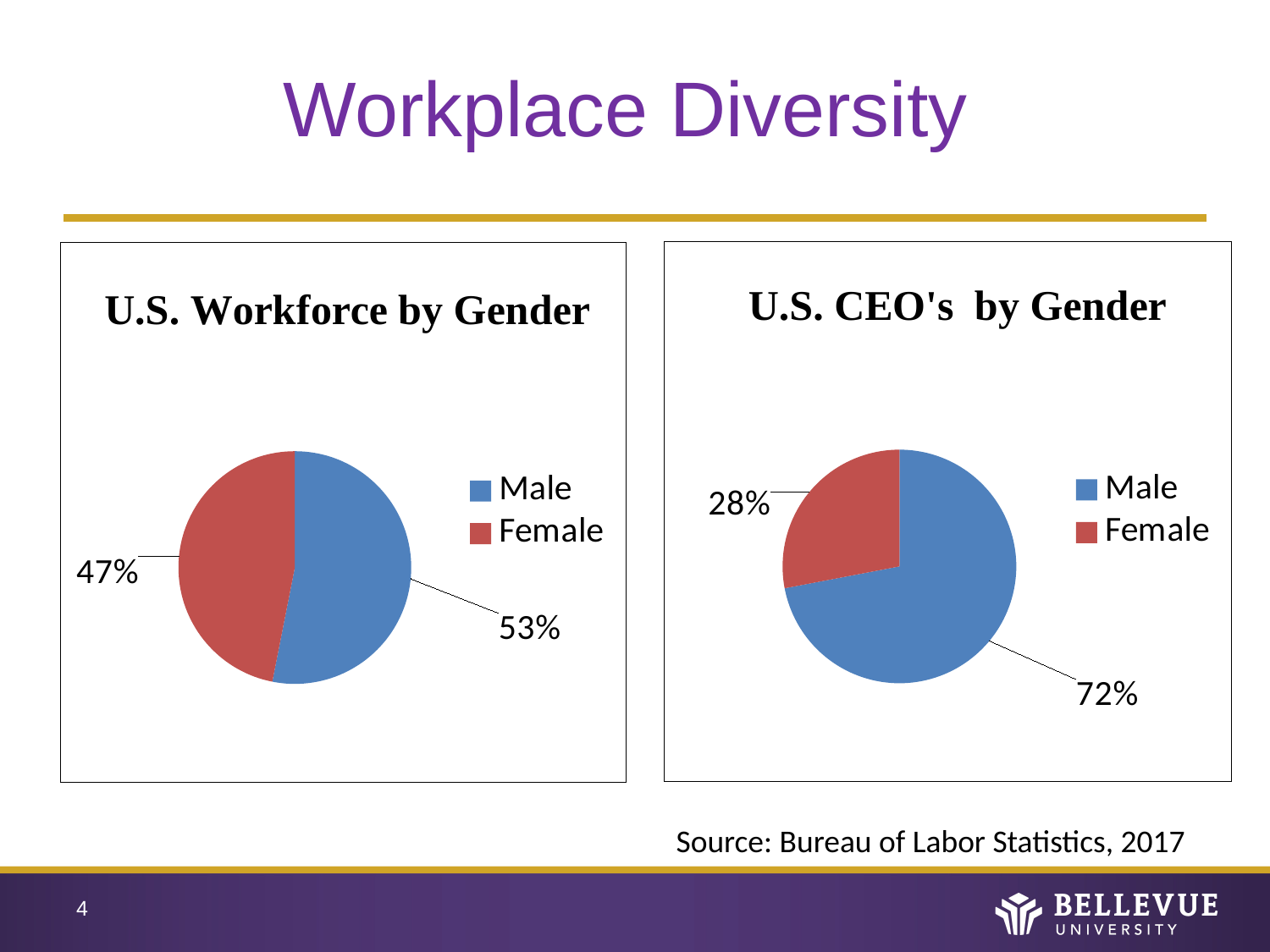
In the 'U.S. Workforce by Gender' chart, what colour represents Female? Red Is the Male share larger in the 'U.S. Workforce by Gender' chart or the 'U.S. CEO's by Gender' chart? U.S. CEO's by Gender In the 'U.S. CEO's by Gender' chart, which category has the largest slice? Male In the 'U.S. Workforce by Gender' chart, what is the difference between the Male and Female percentages? 6% In the 'U.S. CEO's by Gender' chart, what is the difference between the Male and Female percentages? 44% In the 'U.S. CEO's by Gender' chart, what percentage is Male? 72% In the 'U.S. Workforce by Gender' chart, which category has the smallest slice? Female In the 'U.S. CEO's by Gender' chart, what percentage is Female? 28% What type of chart is the 'U.S. Workforce by Gender' chart? Pie chart In the 'U.S. Workforce by Gender' chart, what percentage is Male? 53% In the 'U.S. Workforce by Gender' chart, what percentage is Female? 47% How many categories does the legend of the 'U.S. CEO's by Gender' chart list? 2